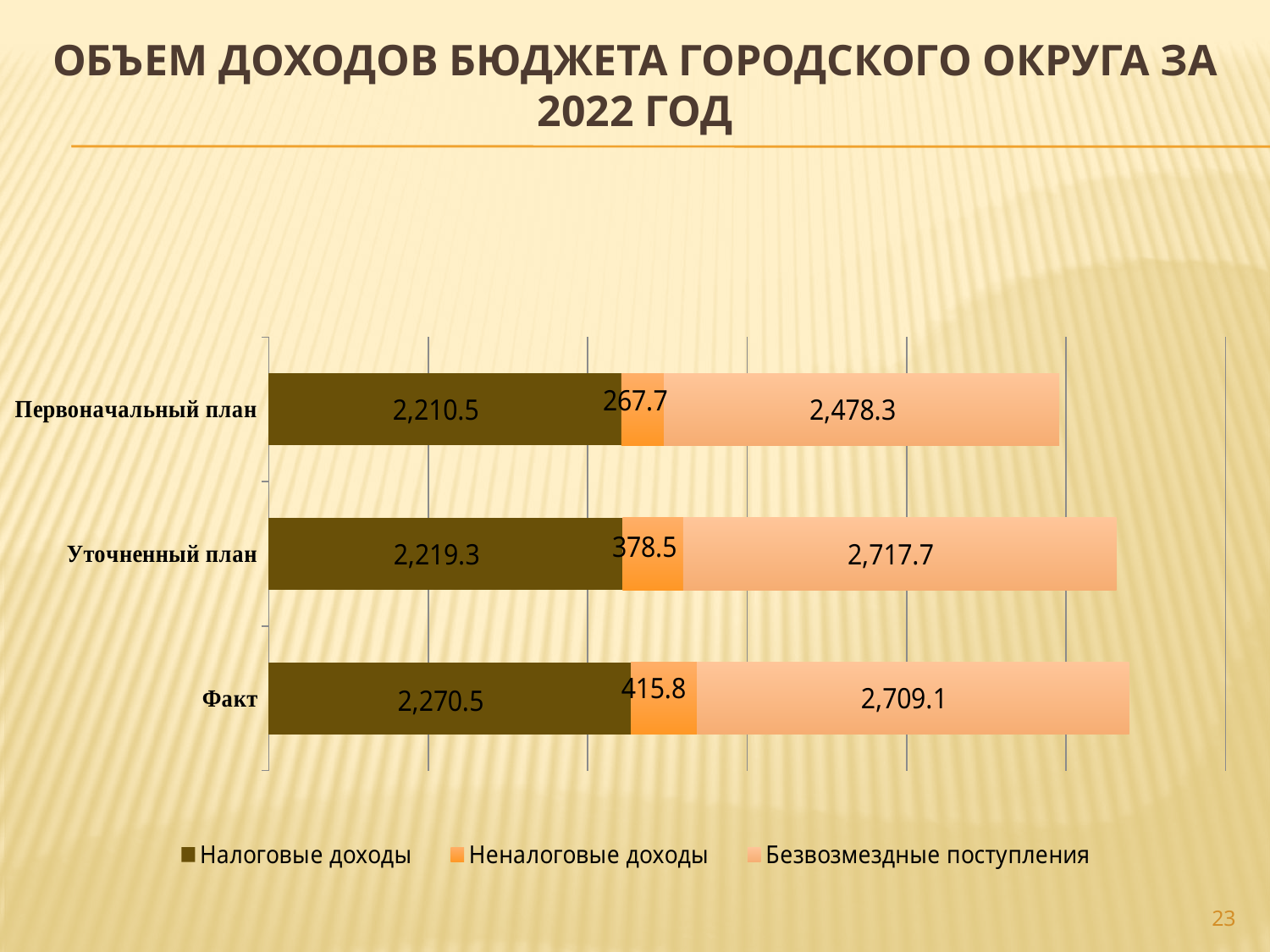
Which is larger: Безвозмездные поступления for Уточненный план or for Факт? Уточненный план What is the value of Безвозмездные поступления for Первоначальный план? 2,478.3 What is the difference between Неналоговые доходы for Факт and for Первоначальный план? 148.1 What is the difference between Налоговые доходы for Факт and for Первоначальный план? 60.0 What is the value of Неналоговые доходы for Уточненный план? 378.5 What is the total of the stacked bar for Первоначальный план? 4,956.5 Which category has the highest value for Налоговые доходы? Факт How many series does the legend list? 3 How many categories are shown on the chart? 3 What is the value of Налоговые доходы for Факт? 2,270.5 Which category has the lowest value for Неналоговые доходы? Первоначальный план What is the total of the stacked bar for Факт? 5,395.4